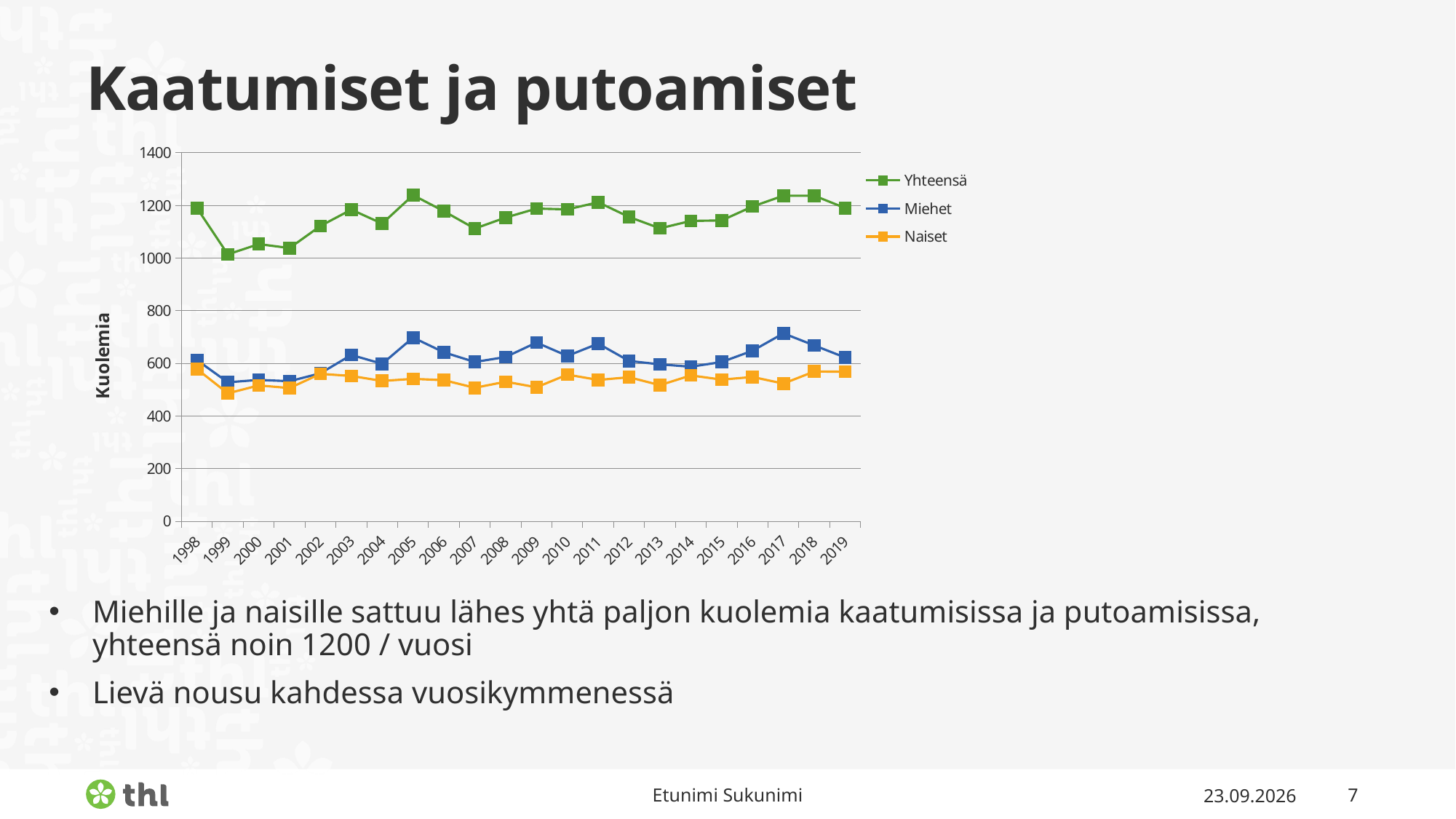
Does the Yhteensä series rise or fall from 1999 to 2005? rise Is the Miehet value for 2005 greater or less than 600? greater What kind of chart is shown on the slide? Line chart In which year is the Naiset series at its lowest? 1999 Is the Yhteensä value for 1999 greater or less than 1200? less How many series does the legend list? 3 Which is larger in 2005, the Miehet value or the Naiset value? Miehet How many years are plotted along the x axis? 22 Is the Yhteensä value for 2005 greater or less than 1200? greater What is the label of the vertical axis? Kuolemia Which series is drawn in green? Yhteensä In which year is the Yhteensä series at its lowest? 1999